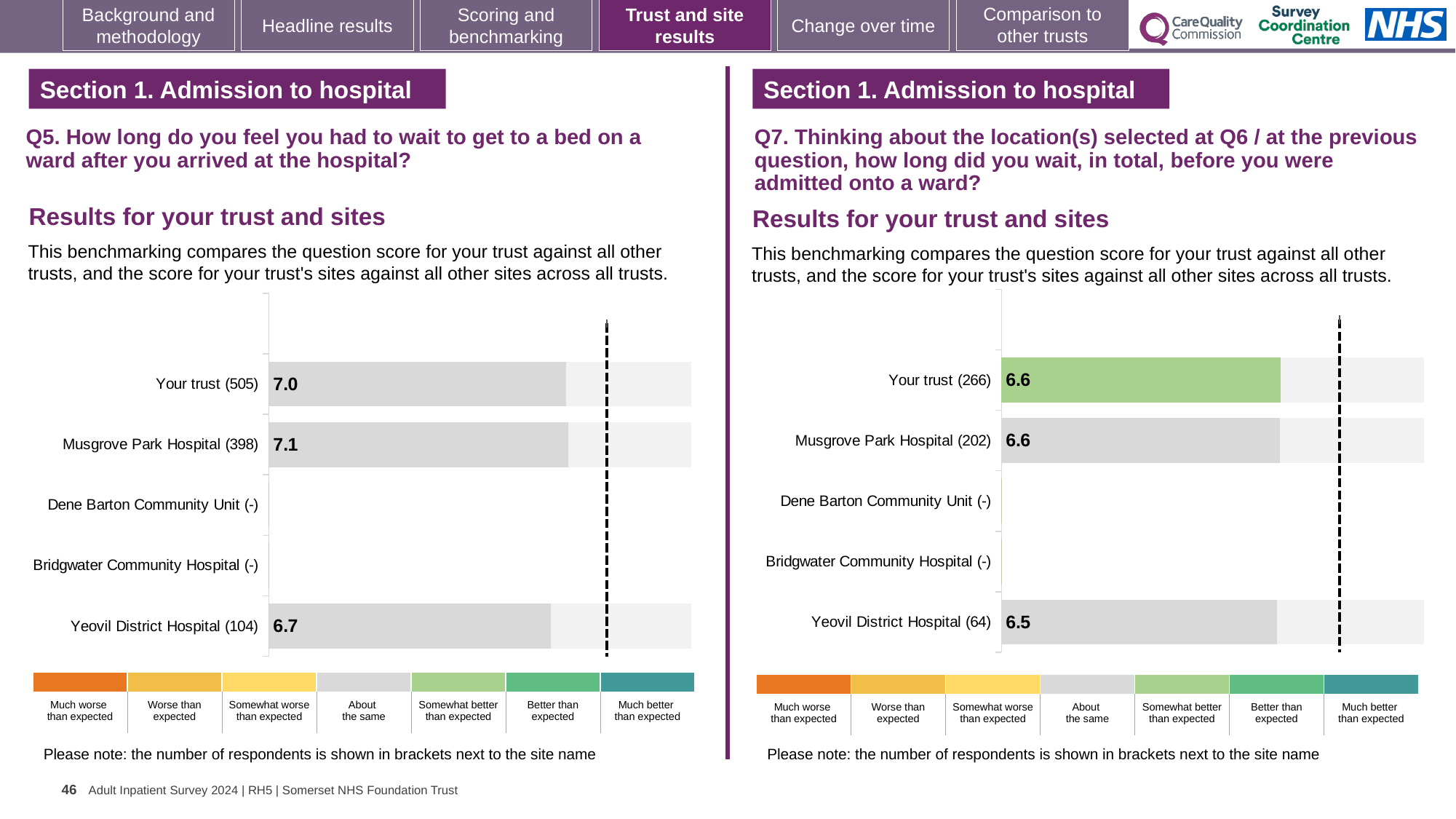
On the Q7 chart (right), what is the score for Your trust (266)? 6.6 On the Q5 chart (left), what is the score for Musgrove Park Hospital (398)? 7.1 On the Q5 chart (left), which site has the highest score? Musgrove Park Hospital On the Q7 chart (right), which benchmark category does the green colour of the Your trust bar correspond to in the legend? Somewhat better than expected On the Q7 chart (right), which site has the lowest printed score? Yeovil District Hospital On the Q5 chart (left), what is the score for Your trust (505)? 7.0 What type of chart is used on the Q7 chart (right)? Bar chart On the Q5 chart (left), what is the difference between the scores for Musgrove Park Hospital and Yeovil District Hospital? 0.4 On the Q7 chart (right), what is the difference between the scores for Your trust and Yeovil District Hospital? 0.1 On the Q5 chart (left), what is the score for Yeovil District Hospital (104)? 6.7 On the Q7 chart (right), what is the score for Yeovil District Hospital (64)? 6.5 On the Q5 chart (left), how many rows (sites including Your trust) are listed? 5